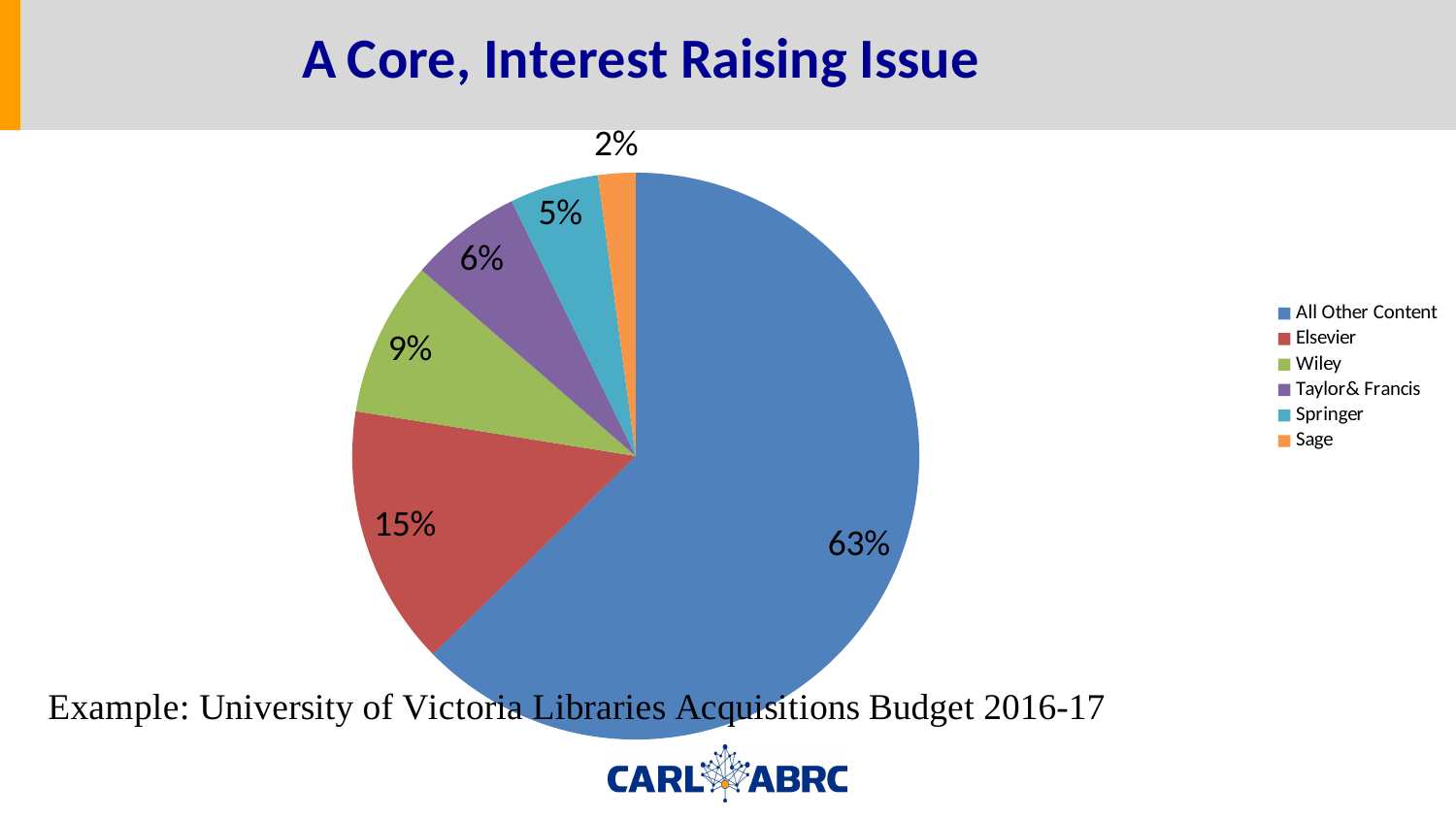
What colour is the Elsevier slice in the pie chart? red How many categories does the legend list? 6 What kind of chart is shown on the slide? pie chart What share of the pie does Elsevier account for? 15% What share of the pie does Wiley account for? 9% Which category has the largest slice of the pie? All Other Content What share of the pie does Taylor & Francis account for? 6% Which slice is larger, Springer or Taylor & Francis? Taylor & Francis Which category has the smallest slice of the pie? Sage What is the difference in percentage points between the Elsevier slice and the Wiley slice? 6%